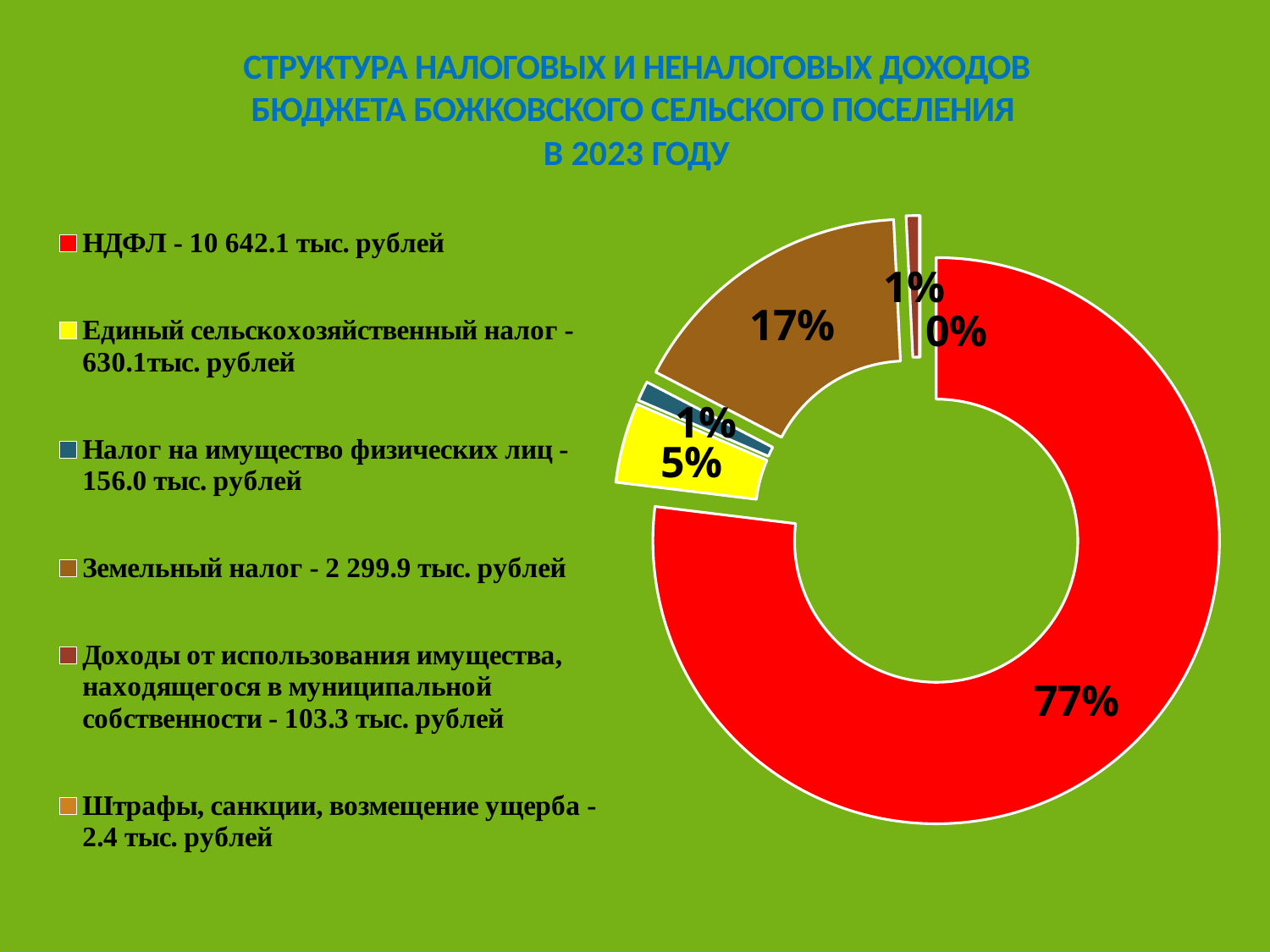
According to the legend, what is the amount for Земельный налог? 2 299.9 тыс. рублей Which category has the smallest share of the chart? Штрафы, санкции, возмещение ущерба What share of the chart does Штрафы, санкции, возмещение ущерба account for? 0% What colour is the slice for НДФЛ? Red How many categories does the chart's legend list? 6 Which category has the largest share of the chart? НДФЛ What share of the chart does Земельный налог account for? 17% Which is larger: the share for Земельный налог or the share for Единый сельскохозяйственный налог? Земельный налог What kind of chart is shown on the slide? Doughnut (pie) chart What share of the chart does НДФЛ account for? 77% What is the difference in percentage points between the share for НДФЛ and the share for Земельный налог? 60%